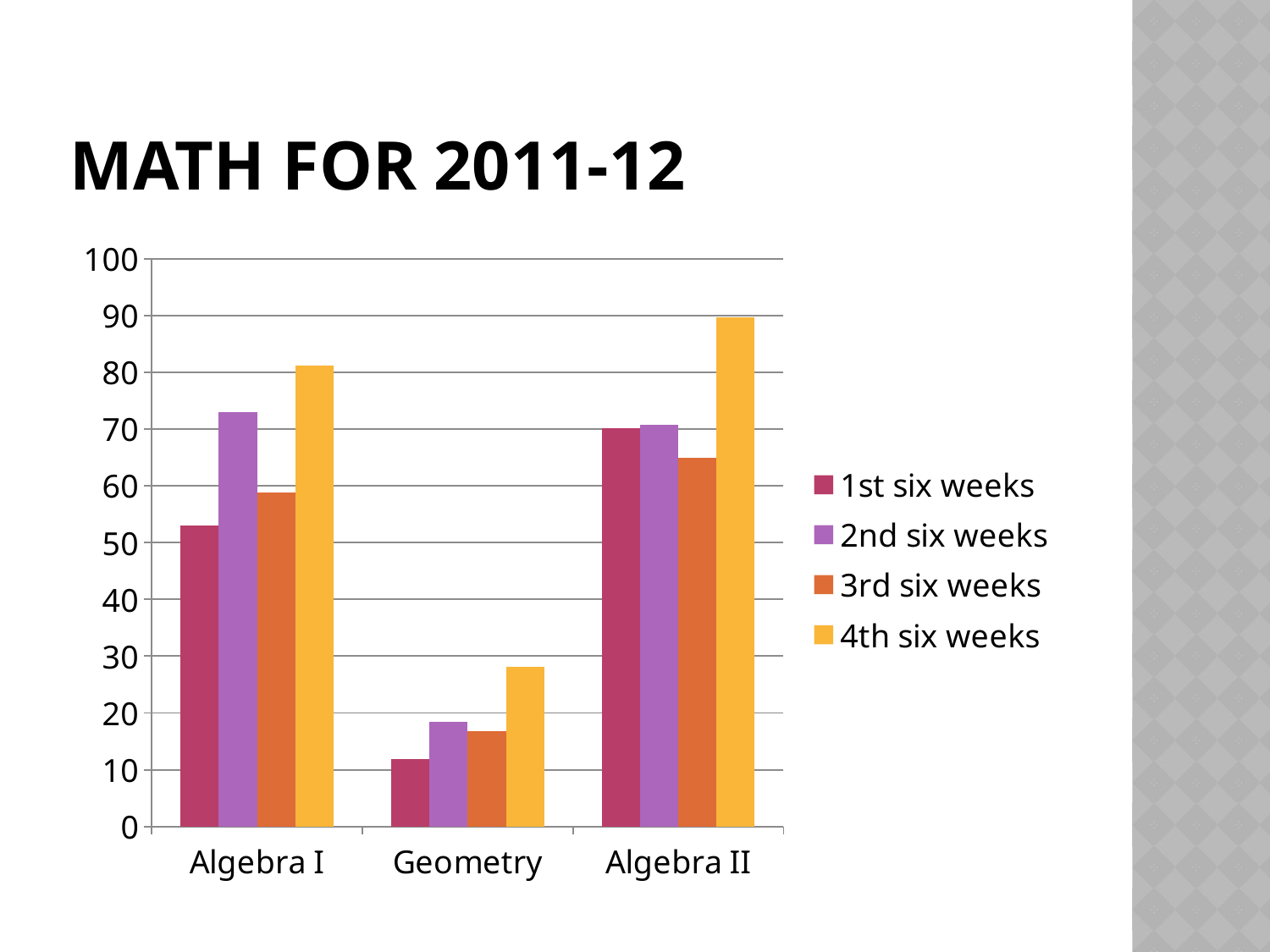
Which series has the highest value in every category? 4th six weeks How many series does the legend list? 4 Is the value for Algebra I in the 4th six weeks greater or less than 70? greater Which is larger for Algebra I: the 2nd six weeks or the 3rd six weeks? 2nd six weeks Which category has the highest value for 4th six weeks? Algebra II What kind of chart is shown on the slide? bar chart Is the value for Algebra I in the 1st six weeks greater or less than 60? less How many categories are shown on the x axis? 3 Is the value for Algebra II in the 3rd six weeks greater or less than 60? greater Which category has the lowest value for 1st six weeks? Geometry What is the title of the slide? MATH FOR 2011-12